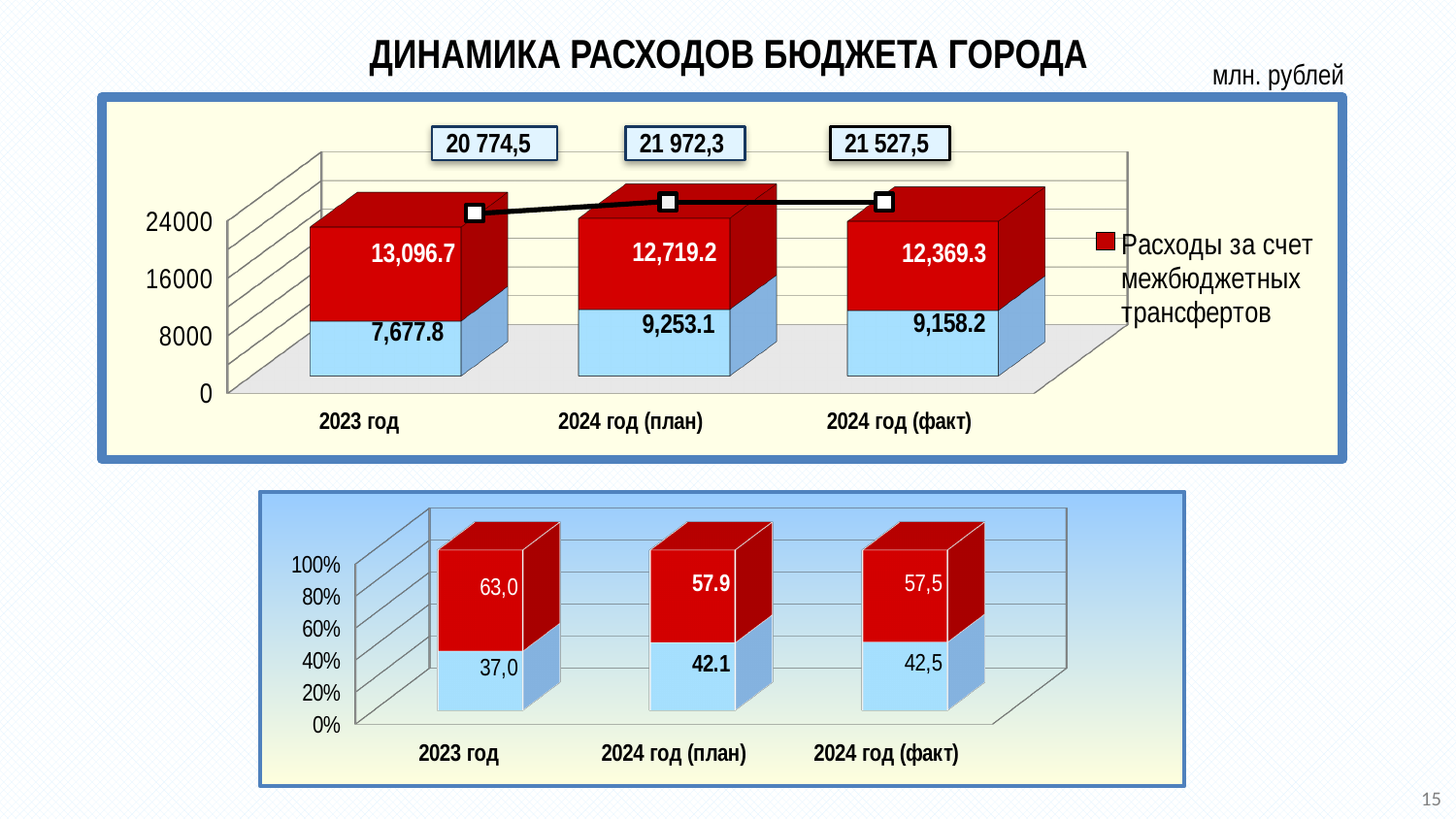
In the bottom chart, what percentage is shown for the light blue segment for 2024 год (факт)? 42,5 In the bottom chart, what percentage is shown for the red segment for 2024 год (план)? 57.9 In the top chart, what total is shown in the box above the 2024 год (факт) bar? 21 527,5 What kind of chart is the bottom chart? stacked bar chart In the top chart, which category has the lowest value for the red segment (Расходы за счет межбюджетных трансфертов)? 2024 год (факт) In the top chart, what is the difference between the light blue segment values for 2024 год (план) and 2023 год? 1,575.3 In the top chart, what is the value of the light blue segment for 2024 год (план)? 9,253.1 In the top chart, what is the value of the red segment (Расходы за счет межбюджетных трансфертов) for 2023 год? 13,096.7 How many series does the legend of the top chart list? 1 In the top chart, is the red segment value for 2023 год larger or smaller than the red segment value for 2024 год (факт)? larger How many categories are shown on the x axis of the top chart? 3 In the top chart, which category has the highest total shown in the boxes above the bars? 2024 год (план)